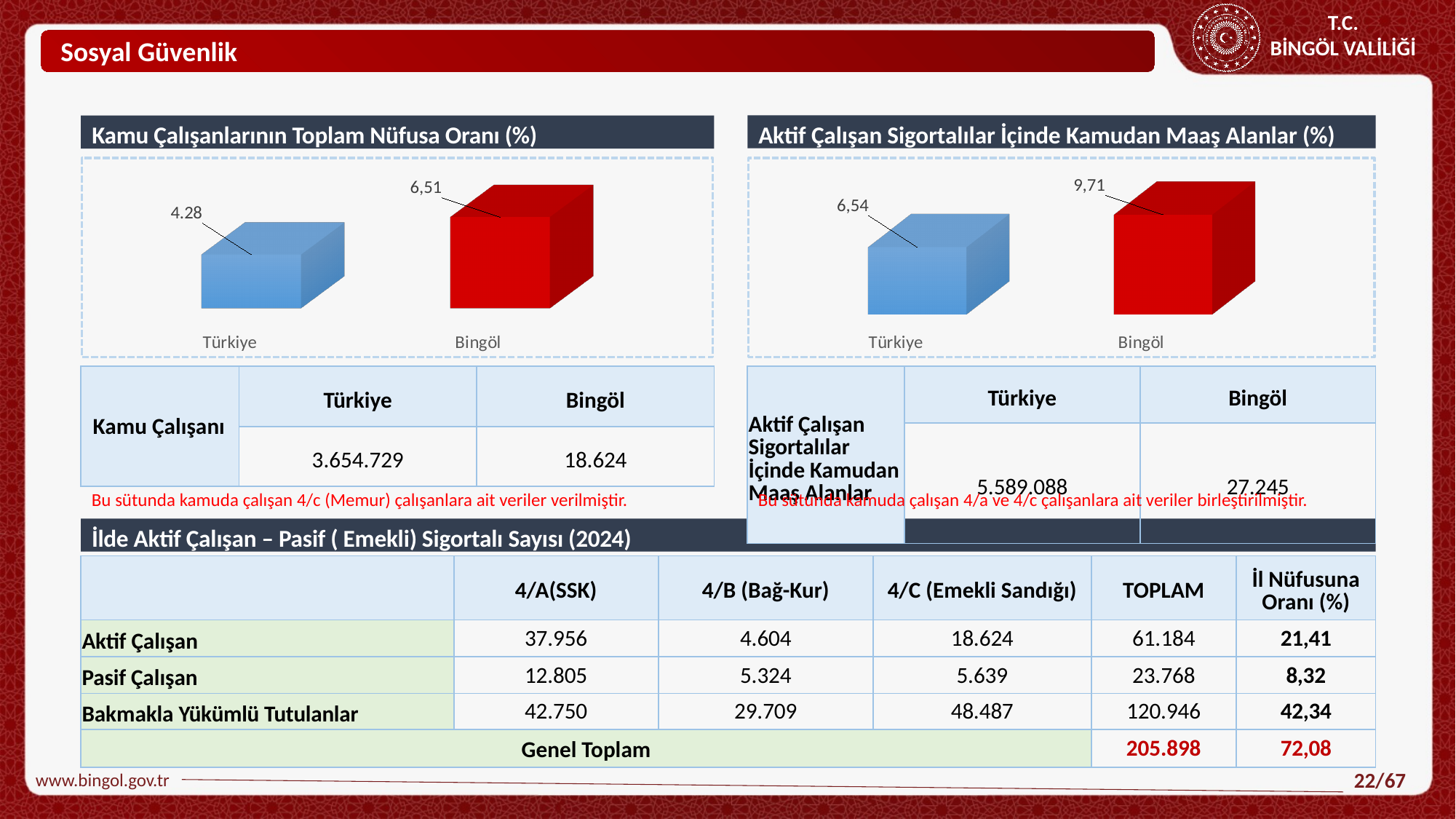
In the chart titled "Kamu Çalışanlarının Toplam Nüfusa Oranı (%)", which category has the higher value? Bingöl In the chart titled "Aktif Çalışan Sigortalılar İçinde Kamudan Maaş Alanlar (%)", which category has the lower value? Türkiye What kind of chart is the one titled "Kamu Çalışanlarının Toplam Nüfusa Oranı (%)"? Bar chart In the chart titled "Aktif Çalışan Sigortalılar İçinde Kamudan Maaş Alanlar (%)", what is the value for Bingöl? 9,71 In the chart titled "Aktif Çalışan Sigortalılar İçinde Kamudan Maaş Alanlar (%)", what is the value for Türkiye? 6,54 In the chart titled "Kamu Çalışanlarının Toplam Nüfusa Oranı (%)", what is the value for Bingöl? 6,51 In the chart titled "Aktif Çalışan Sigortalılar İçinde Kamudan Maaş Alanlar (%)", what is the difference between the Bingöl and Türkiye values? 3,17 In the chart titled "Aktif Çalışan Sigortalılar İçinde Kamudan Maaş Alanlar (%)", is the value for Bingöl larger or smaller than the value for Türkiye? Larger In the chart titled "Kamu Çalışanlarının Toplam Nüfusa Oranı (%)", what colour is the bar for Bingöl? Red In the chart titled "Kamu Çalışanlarının Toplam Nüfusa Oranı (%)", how many categories are plotted? 2 In the chart titled "Aktif Çalışan Sigortalılar İçinde Kamudan Maaş Alanlar (%)", what colour is the bar for Türkiye? Blue In the chart titled "Kamu Çalışanlarının Toplam Nüfusa Oranı (%)", what is the value for Türkiye? 4.28